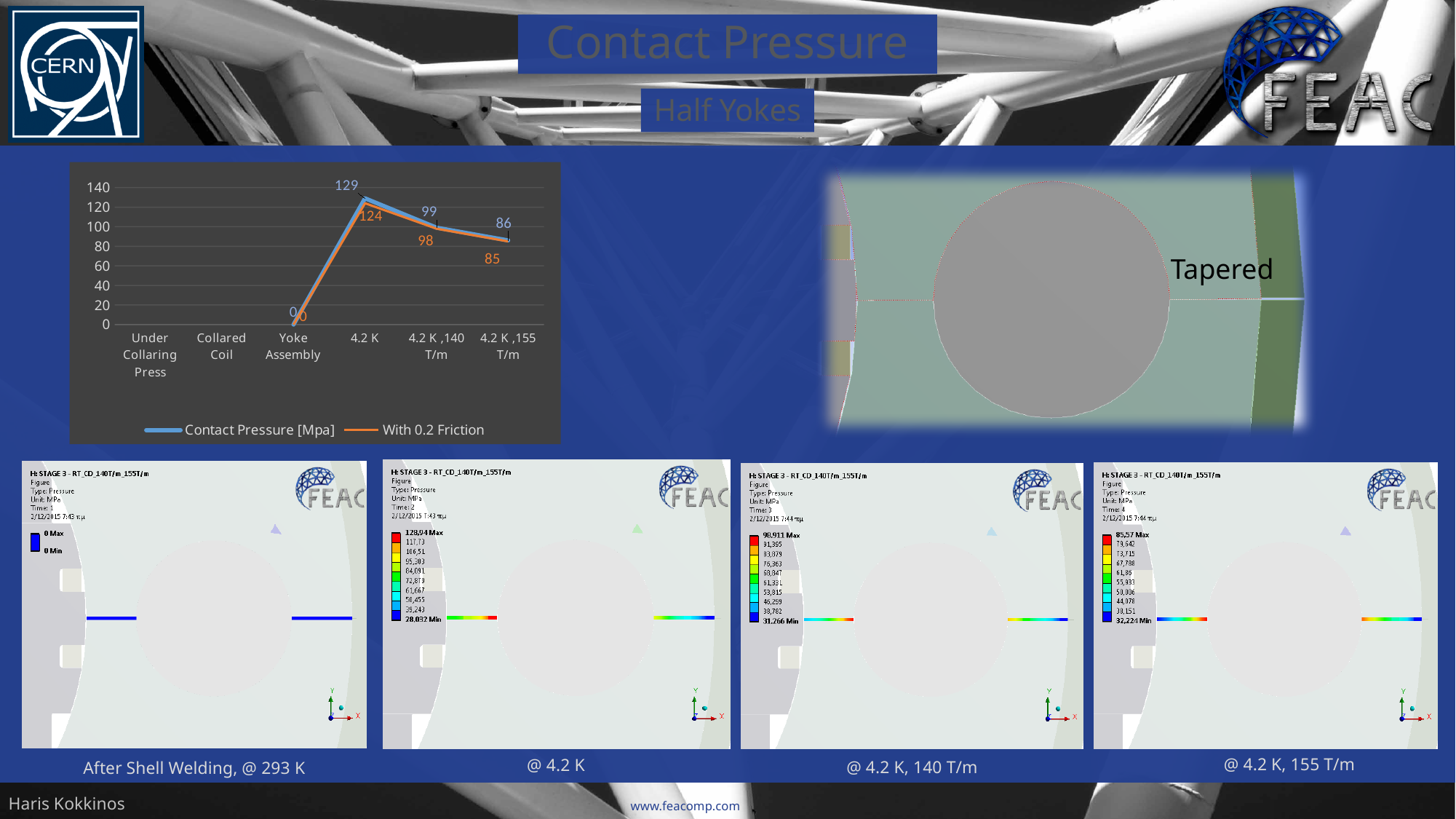
Which is larger at 4.2 K ,140 T/m: the Contact Pressure [Mpa] value or the With 0.2 Friction value? Contact Pressure [Mpa] What is the difference between the Contact Pressure [Mpa] values at 4.2 K and at 4.2 K ,155 T/m? 43 What is the Contact Pressure [Mpa] value at 4.2 K ,140 T/m? 99 What is the difference between the Contact Pressure [Mpa] value and the With 0.2 Friction value at 4.2 K? 5 What is the Contact Pressure [Mpa] value at 4.2 K? 129 From 4.2 K to 4.2 K ,155 T/m, do the Contact Pressure [Mpa] values rise or fall? fall What is the With 0.2 Friction value at 4.2 K ,155 T/m? 85 At which category does the Contact Pressure [Mpa] series reach its highest value? 4.2 K What is the With 0.2 Friction value at 4.2 K? 124 How many series does the chart legend list? 2 What type of chart is shown on the slide? line chart How many categories are shown on the x axis of the chart? 6